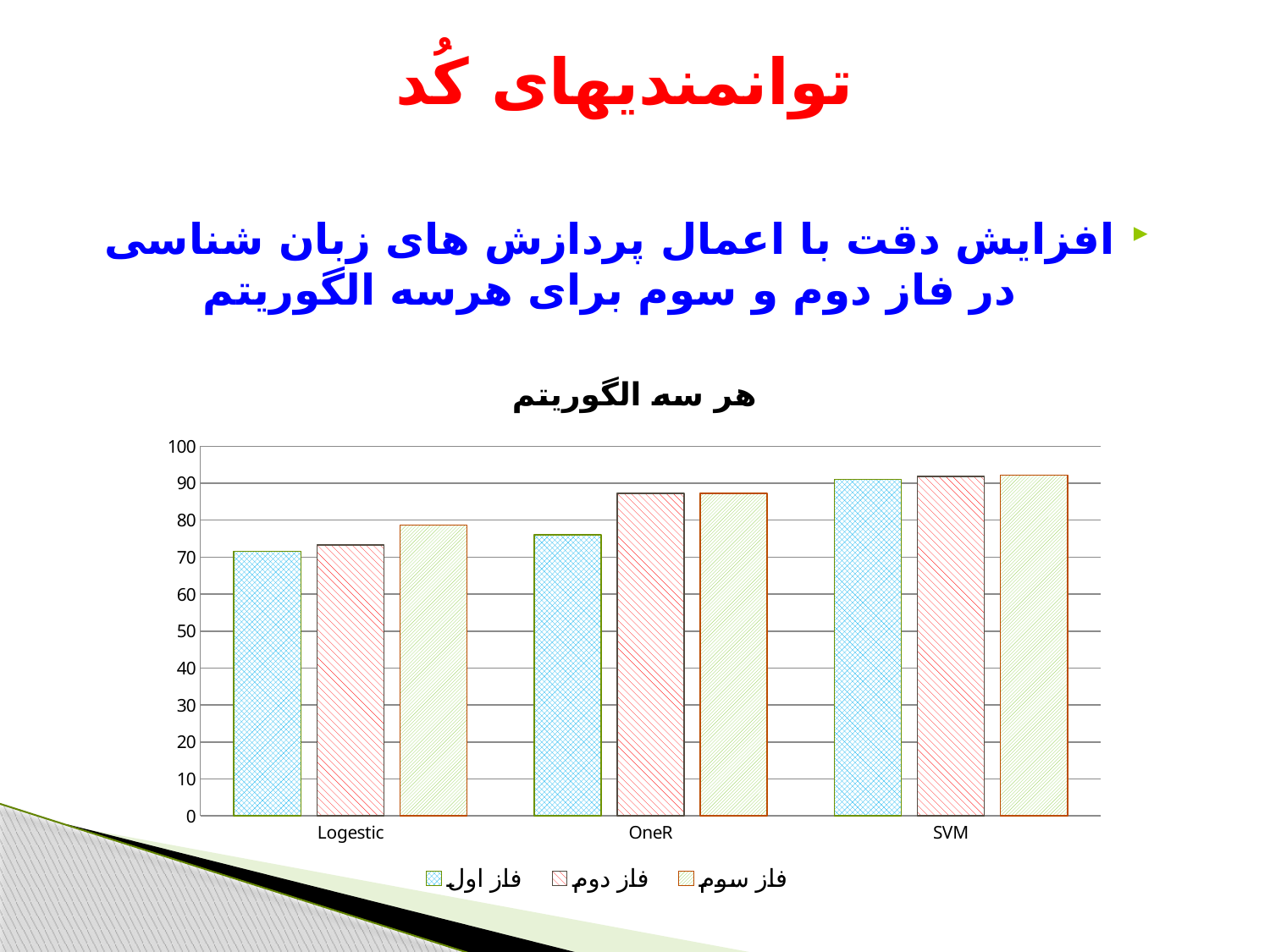
Which category has the lowest value for the فاز سوم series? Logestic Is the value for فاز دوم at OneR greater or less than 80? greater For OneR, which is larger: the فاز اول value or the فاز دوم value? فاز دوم Which category has the lowest value for the فاز دوم series? Logestic Which category has the highest value for the فاز اول series? SVM How many categories are shown on the x axis of the chart? 3 Is the value for فاز اول at Logestic greater or less than 80? less How many series does the chart's legend list? 3 What kind of chart is shown on the slide? bar chart What is the title of the chart? هر سه الگوریتم For Logestic, which is larger: the فاز اول value or the فاز سوم value? فاز سوم Do the values for the فاز اول series rise or fall from Logestic to SVM along the x axis? rise